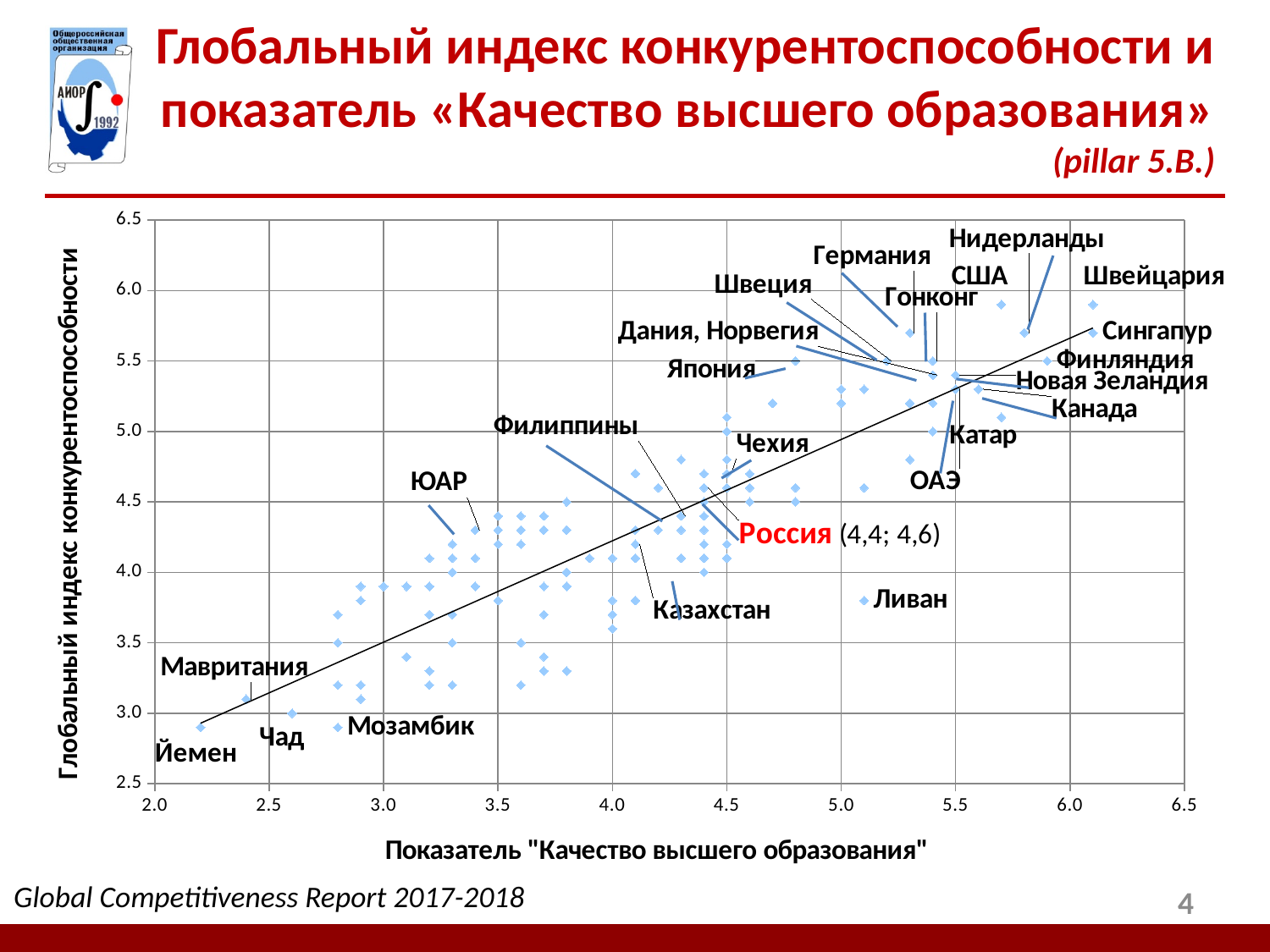
What is the value of the indicator «Качество высшего образования» for Россия? 4,4 Which labeled country has the lowest «Качество высшего образования» value? Йемен What are the coordinates printed next to the point for Россия? (4,4; 4,6) Is the «Качество высшего образования» value for Мавритания greater or less than 3.0? less What is the title of the horizontal axis? Показатель "Качество высшего образования" What is the Global Competitiveness Index value for Россия? 4,6 Is the Global Competitiveness Index value for Швейцария greater or less than 5.5? greater What source is cited below the chart? Global Competitiveness Report 2017-2018 Is the Global Competitiveness Index value for Ливан greater or less than 4.0? less What kind of chart is shown on the slide? scatter plot Which has the higher Global Competitiveness Index value, Сингапур or Казахстан? Сингапур